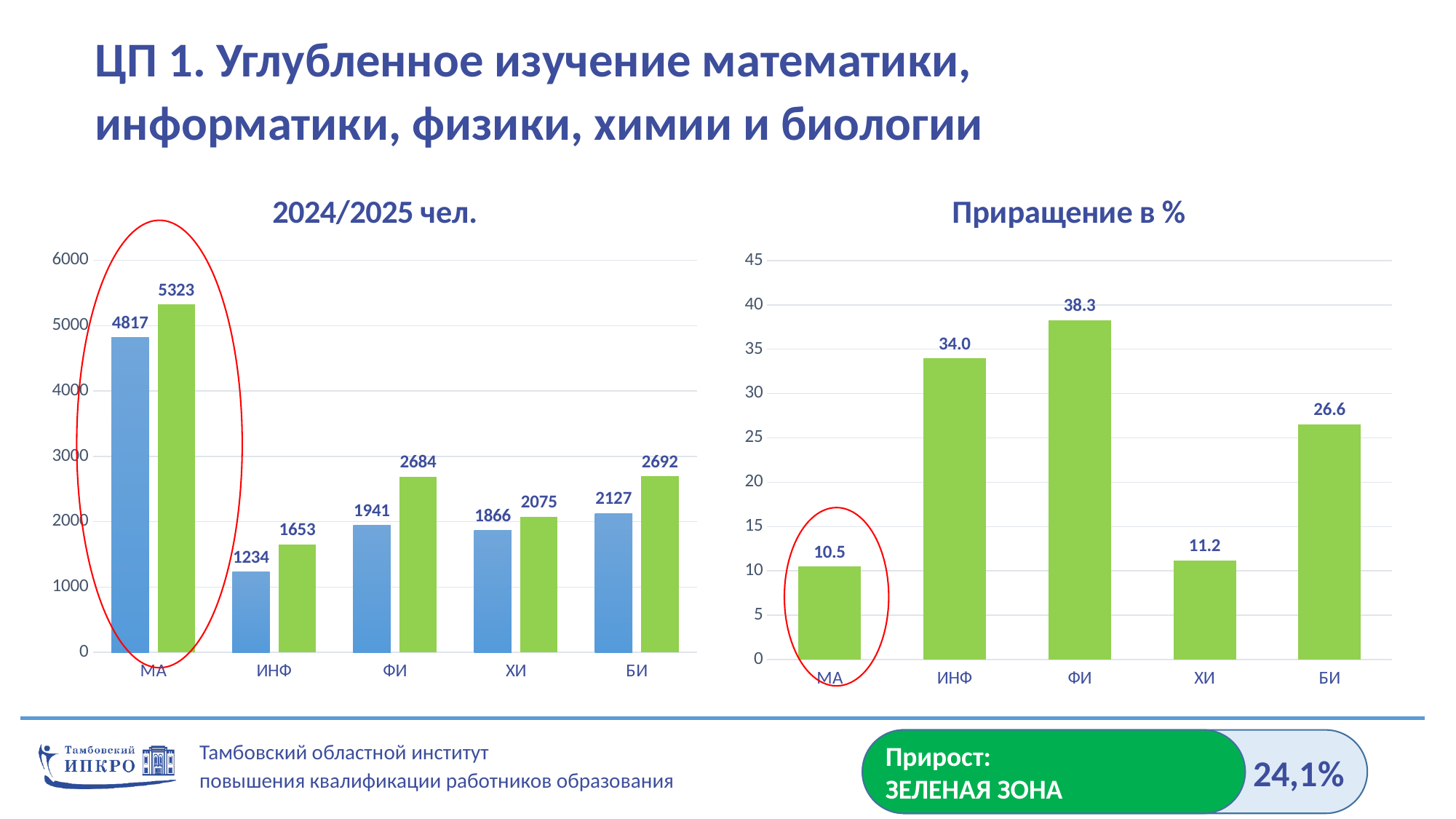
In the chart titled "2024/2025 чел.", is the green bar for БИ greater or less than 3000? less In the chart titled "2024/2025 чел.", what is the value of the green bar for МА? 5323 What kind of chart is the chart titled "Приращение в %"? Bar chart In the chart titled "Приращение в %", which is larger, the value for ИНФ or the value for БИ? ИНФ In the chart titled "2024/2025 чел.", what is the value of the blue bar for ИНФ? 1234 In the chart titled "Приращение в %", what is the value for ФИ? 38.3 In the chart titled "2024/2025 чел.", which category has the lowest blue bar? ИНФ In the chart titled "Приращение в %", which category has the lowest value? МА In the chart titled "2024/2025 чел.", which category has the highest green bar? МА In the chart titled "2024/2025 чел.", what is the difference between the green and blue bars for ФИ? 743 In the chart titled "2024/2025 чел.", how many categories are shown on the x axis? 5 In the chart titled "Приращение в %", what is the difference between the values for ФИ and ХИ? 27.1